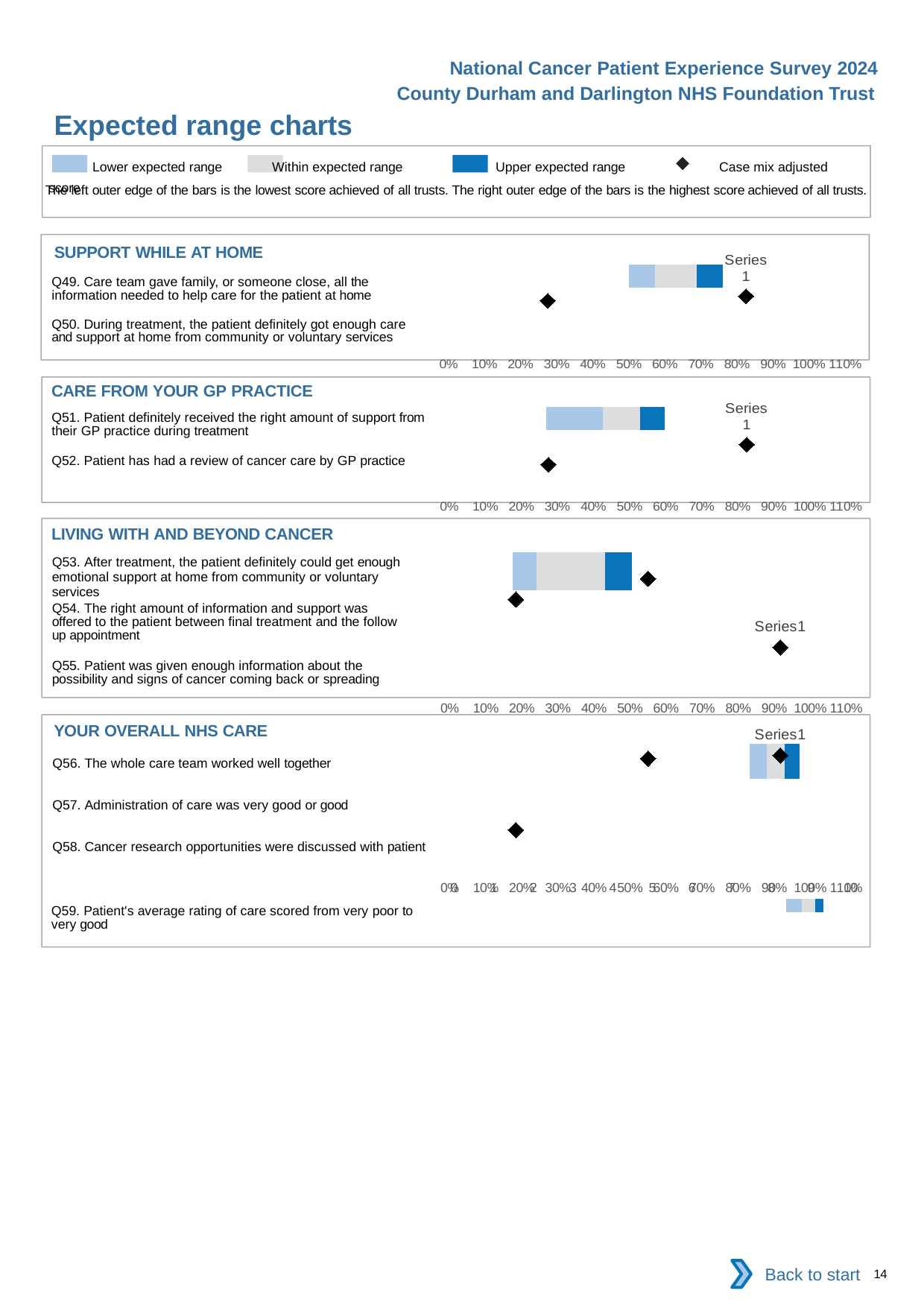
How many questions are listed in the YOUR OVERALL NHS CARE section? 4 In the SUPPORT WHILE AT HOME chart, is the right edge of the expected range bar greater or less than 60%? greater What kind of chart is used in the SUPPORT WHILE AT HOME section? bar chart In the CARE FROM YOUR GP PRACTICE chart, is the right edge of the expected range bar greater or less than 50%? greater In the CARE FROM YOUR GP PRACTICE chart, is the left edge of the expected range bar greater or less than 40%? less In the legend, which colour represents the Upper expected range? dark blue What is the highest value shown on the x axis of the CARE FROM YOUR GP PRACTICE chart? 110% How many entries does the legend at the top of the slide list? 4 How many questions are listed in the LIVING WITH AND BEYOND CANCER section? 3 How many questions are listed in the SUPPORT WHILE AT HOME section? 2